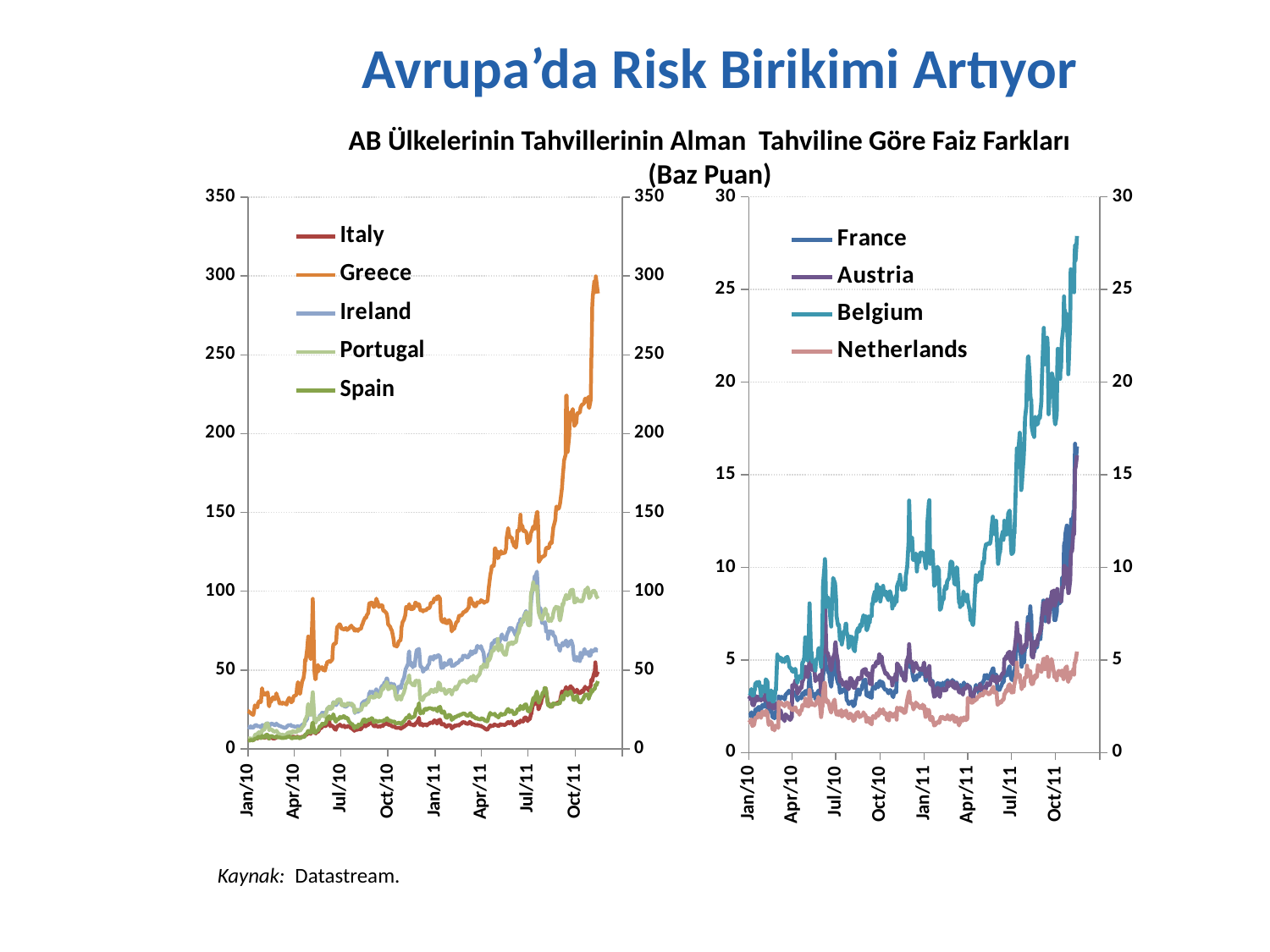
What kind of chart is the left chart (Italy, Greece, Ireland, Portugal, Spain)? line chart What is the title shown above the two charts? AB Ülkelerinin Tahvillerinin Alman Tahviline Göre Faiz Farkları (Baz Puan) In the right chart, is the value for Belgium at the end of the period greater or less than 25? greater In the right chart, which country's line is the lowest at the end of the period? Netherlands In the right chart, is the value for Netherlands at the end of the period greater or less than 10? less In the left chart, does the Greece line generally rise or fall from Jan/10 to the end of the period? rise In the left chart, at the end of the period, which is larger: Portugal or Ireland? Portugal How many series does the legend of the left chart list? 5 In the left chart, which country's line reaches the highest value? Greece In the left chart, is the value for Greece at the end of the period greater or less than 250? greater How many series does the legend of the right chart list? 4 In the right chart, which country's line reaches the highest value? Belgium